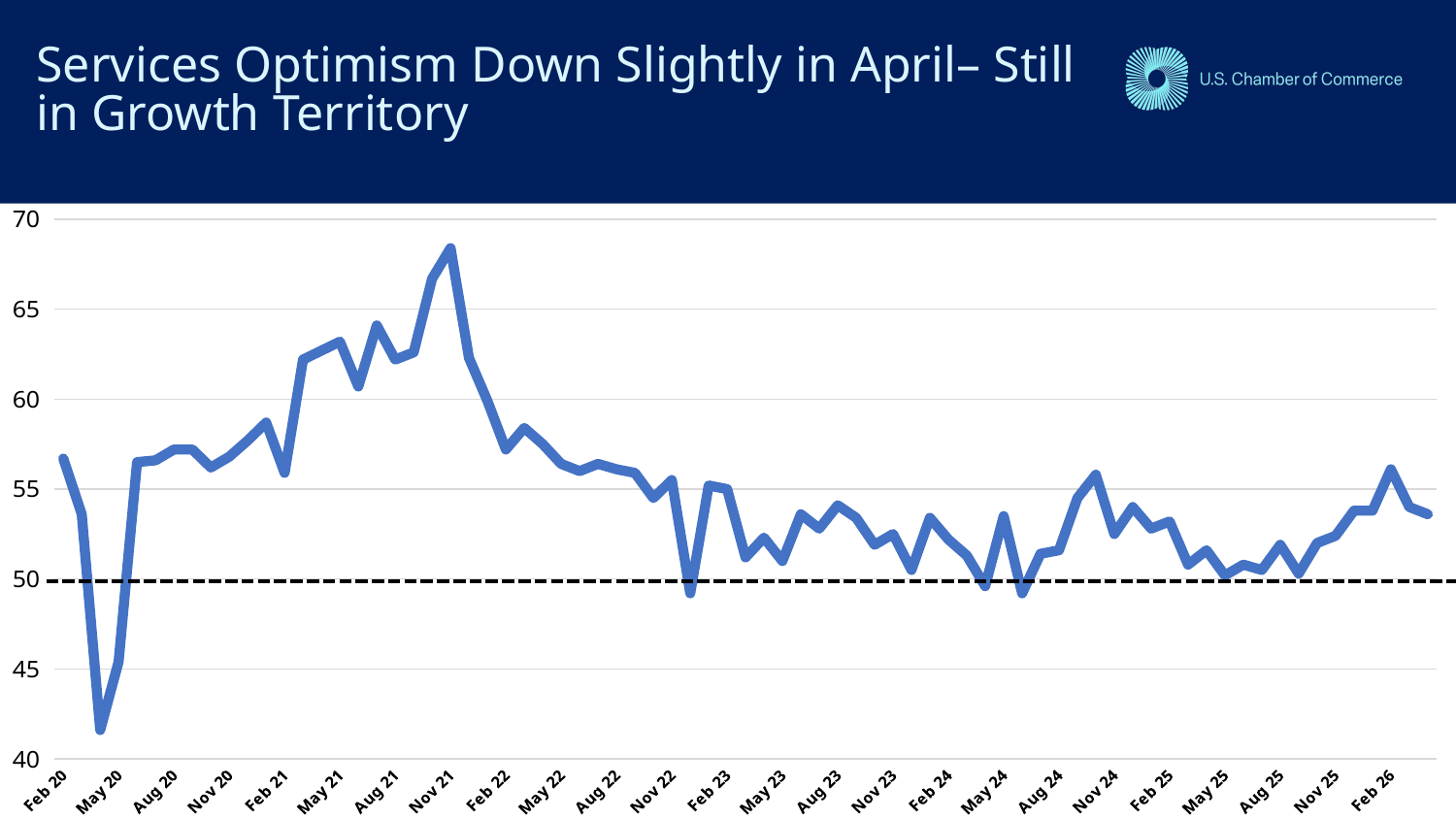
What kind of chart is shown on the slide? line chart How many month labels are shown on the x axis? 25 Is the value at Feb 23 greater or less than 50? greater Is the value at May 25 greater or less than 55? less What is the title of the slide? Services Optimism Down Slightly in April– Still in Growth Territory Is the value at Aug 21 greater or less than 60? greater Near which x-axis label does the line reach its lowest value? May 20 Near which x-axis label does the line reach its highest value? Nov 21 At what value on the y axis is the horizontal dashed line drawn? 50 Does the line generally rise or fall between Nov 21 and Feb 23? fall